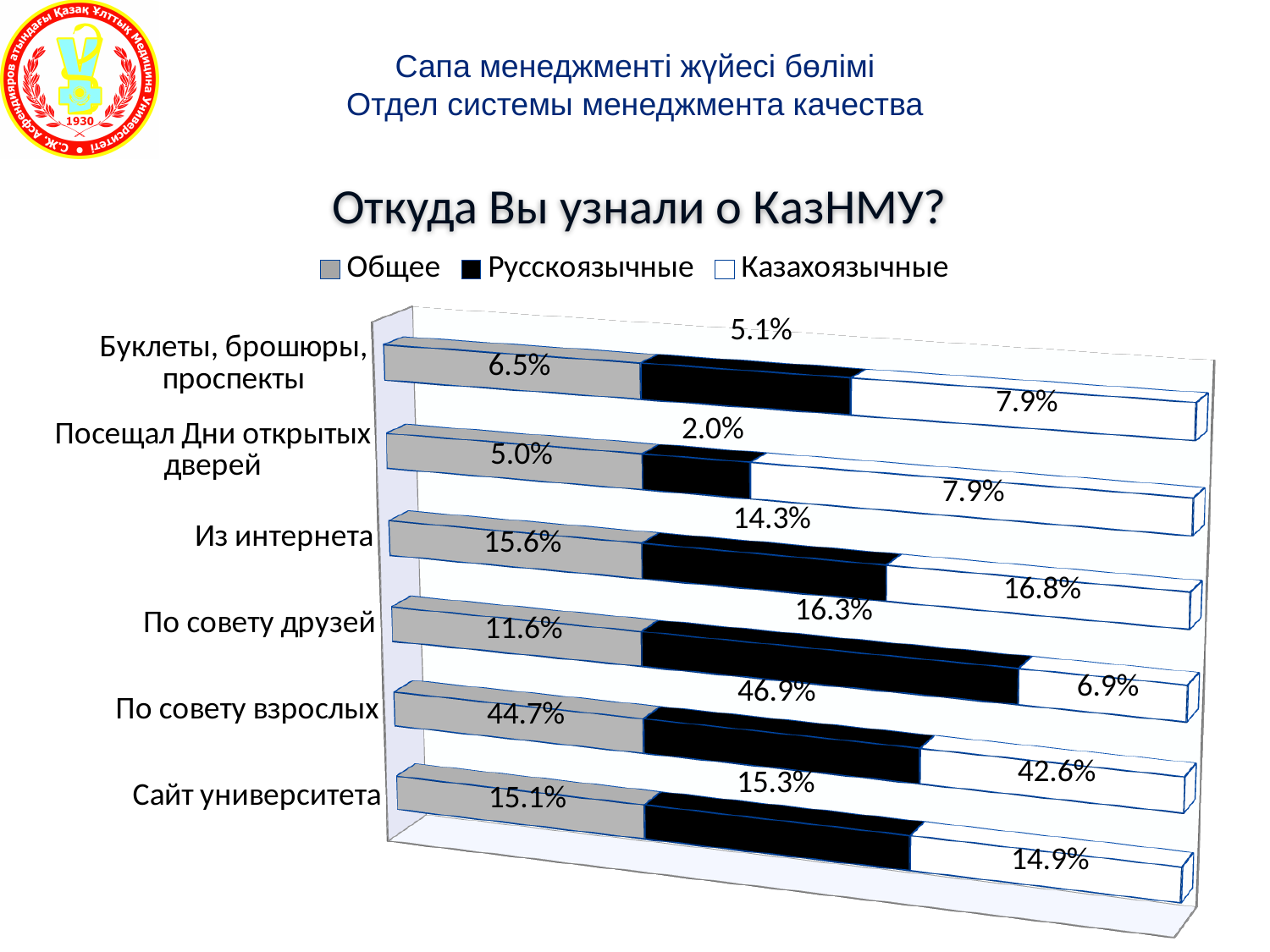
What is the title of the chart? Откуда Вы узнали о КазНМУ? Which is larger for 'Сайт университета': the Русскоязычные value or the Казахоязычные value? Русскоязычные What is the value for Казахоязычные in the category 'По совету друзей'? 6.9% Which category has the highest value for the Общее series? По совету взрослых What is the value for Русскоязычные in the category 'Посещал Дни открытых дверей'? 2.0% What is the difference between the Русскоязычные and Казахоязычные values for 'По совету друзей'? 9.4% What is the value for Общее in the category 'По совету взрослых'? 44.7% What kind of chart is shown on the slide? Bar chart How many categories are shown on the chart? 6 How many series does the legend list? 3 Which category has the lowest value for the Русскоязычные series? Посещал Дни открытых дверей What is the value for Русскоязычные in the category 'Из интернета'? 14.3%